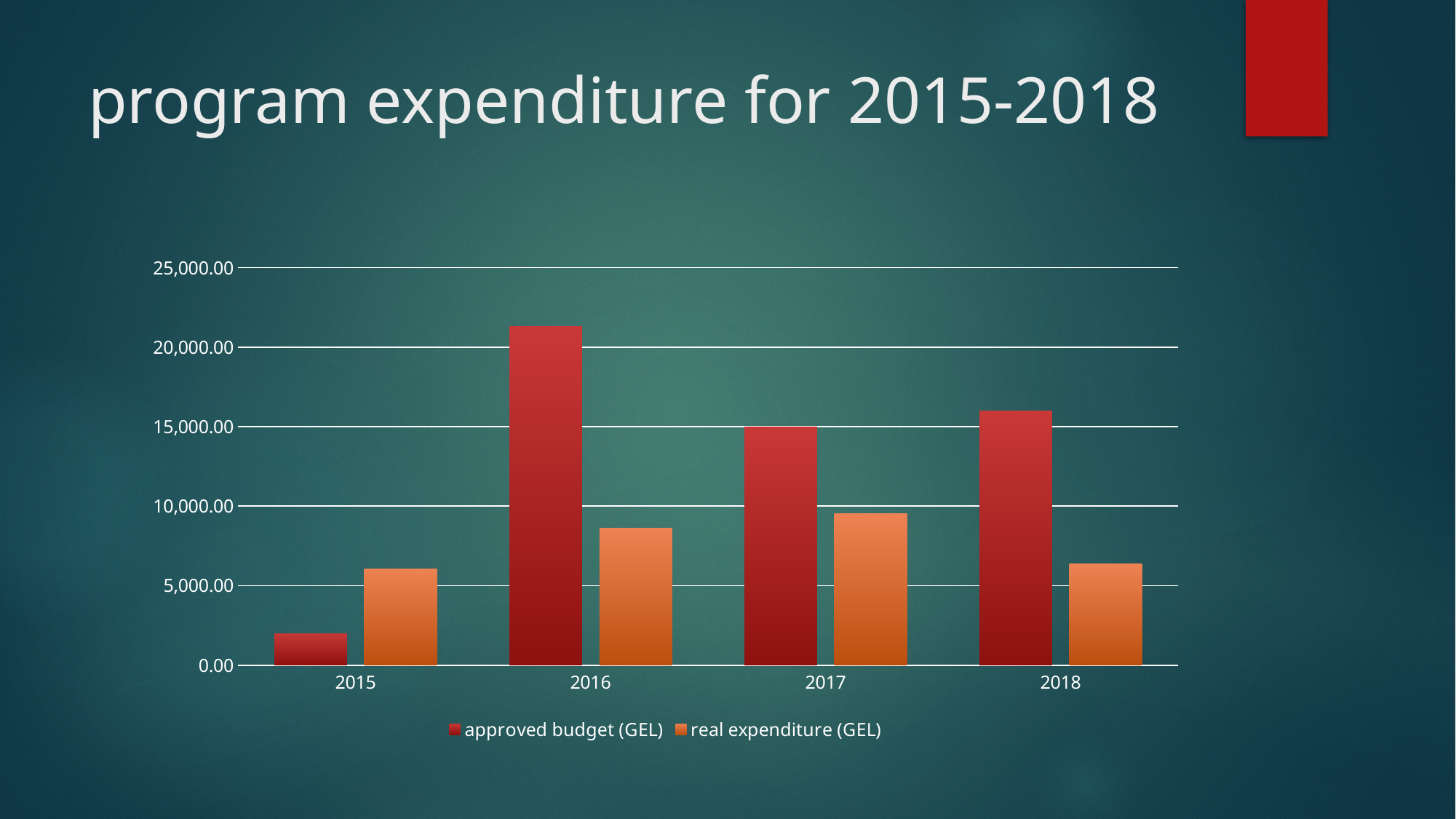
Is the approved budget (GEL) for 2015 greater or less than 5,000.00? less How many years are shown on the x axis? 4 Which year has the highest approved budget (GEL)? 2016 In 2015, which is larger: the approved budget (GEL) or the real expenditure (GEL)? real expenditure (GEL) How many series does the legend list? 2 Is the real expenditure (GEL) for 2017 greater or less than 10,000.00? less What kind of chart is shown on the slide? bar chart In 2018, which is larger: the approved budget (GEL) or the real expenditure (GEL)? approved budget (GEL) Is the approved budget (GEL) for 2016 greater or less than 20,000.00? greater What is the title of the slide? program expenditure for 2015-2018 Which year has the lowest approved budget (GEL)? 2015